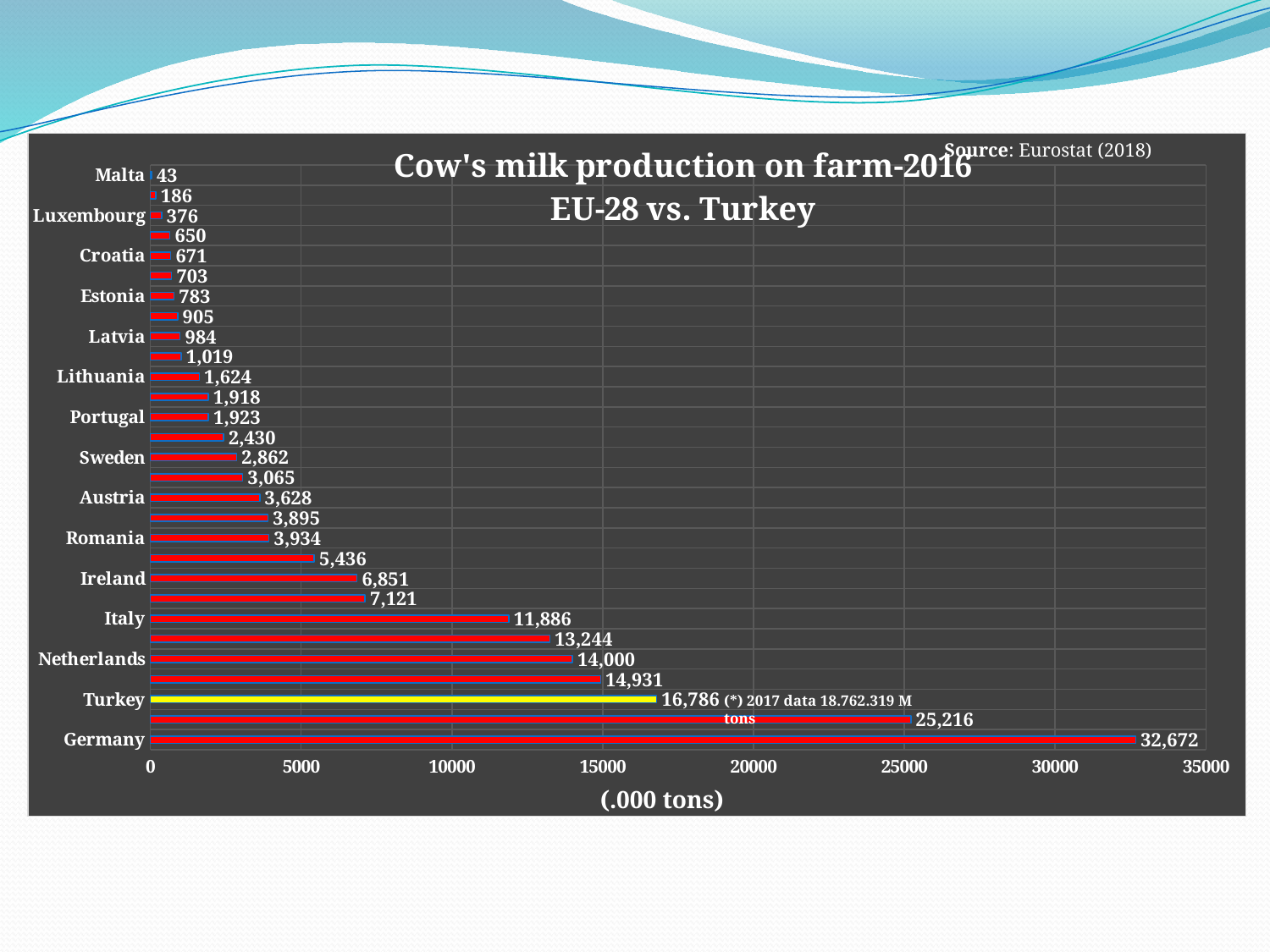
What is the value for Turkey? 16,786 What is the difference between the values for Netherlands and Italy? 2,114 Which country has the lowest cow's milk production? Malta Which is larger, the value for Ireland or the value for Romania? Ireland What is the difference between the values for Germany and Turkey? 15,886 What is the value for Netherlands? 14,000 What is the value for Germany? 32,672 What kind of chart is shown on the slide? Bar chart What unit is shown on the x axis of the chart? (.000 tons) Which country has the highest cow's milk production? Germany What is the value for Malta? 43 Is the value for Turkey greater or less than 15000? greater